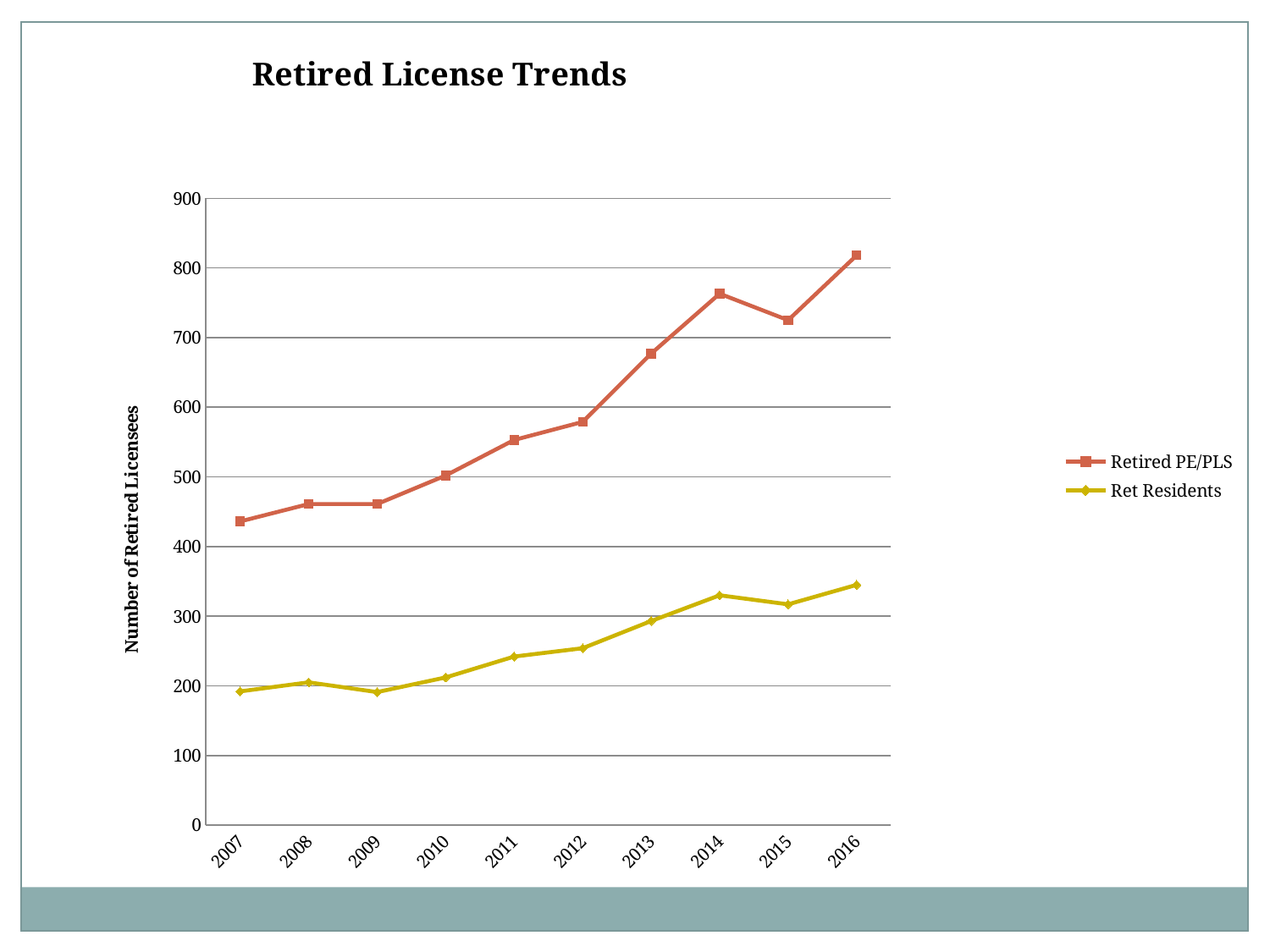
In which year is the Retired PE/PLS series at its highest? 2016 Overall, do the Ret Residents values rise or fall from 2007 to 2016? rise In which year is the Ret Residents series at its highest? 2016 What kind of chart is shown on the slide? line chart How many series does the legend list? 2 Is the Retired PE/PLS value for 2012 greater or less than 600? less Which is larger for Retired PE/PLS: the value in 2014 or the value in 2015? 2014 Is the Ret Residents value for 2014 greater or less than 300? greater How many years are plotted along the x axis? 10 In which year is the Retired PE/PLS series at its lowest? 2007 Is the Retired PE/PLS value for 2016 greater or less than 800? greater What is the title of the chart? Retired License Trends